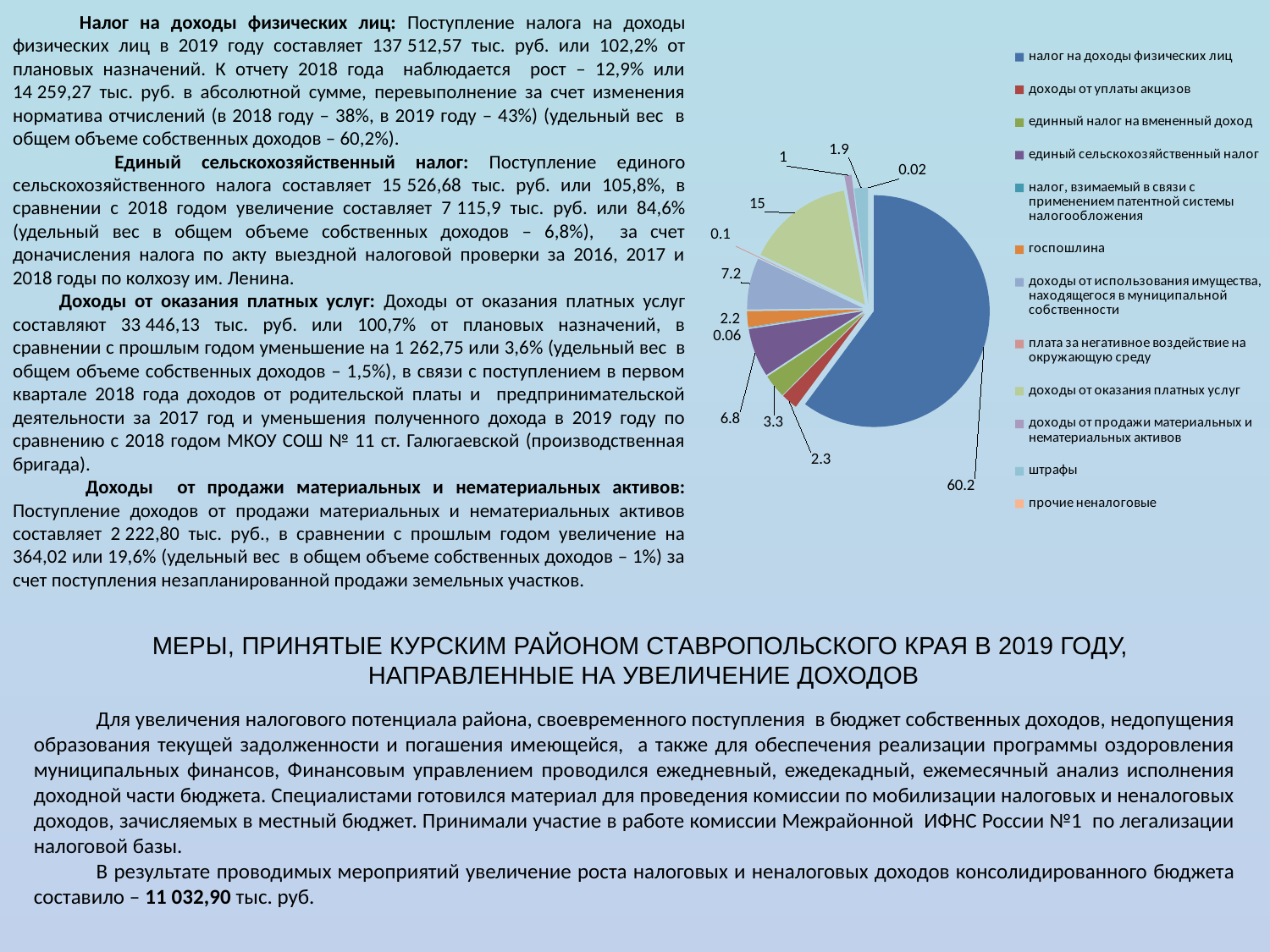
Which category has the smallest slice of the pie? прочие неналоговые What kind of chart is shown on the slide? pie chart How many entries does the chart legend list? 12 What colour is the slice for налог на доходы физических лиц? blue What is the value shown for доходы от продажи материальных и нематериальных активов? 1 What is the value shown for единый сельскохозяйственный налог? 6.8 What is the difference between the values for налог на доходы физических лиц and доходы от оказания платных услуг? 45.2 Which category has the largest slice of the pie? налог на доходы физических лиц What is the value shown for налог на доходы физических лиц? 60.2 How many slices does the pie chart have? 12 Which is larger: the value for доходы от использования имущества, находящегося в муниципальной собственности or the value for единый сельскохозяйственный налог? доходы от использования имущества, находящегося в муниципальной собственности What is the value shown for доходы от оказания платных услуг? 15